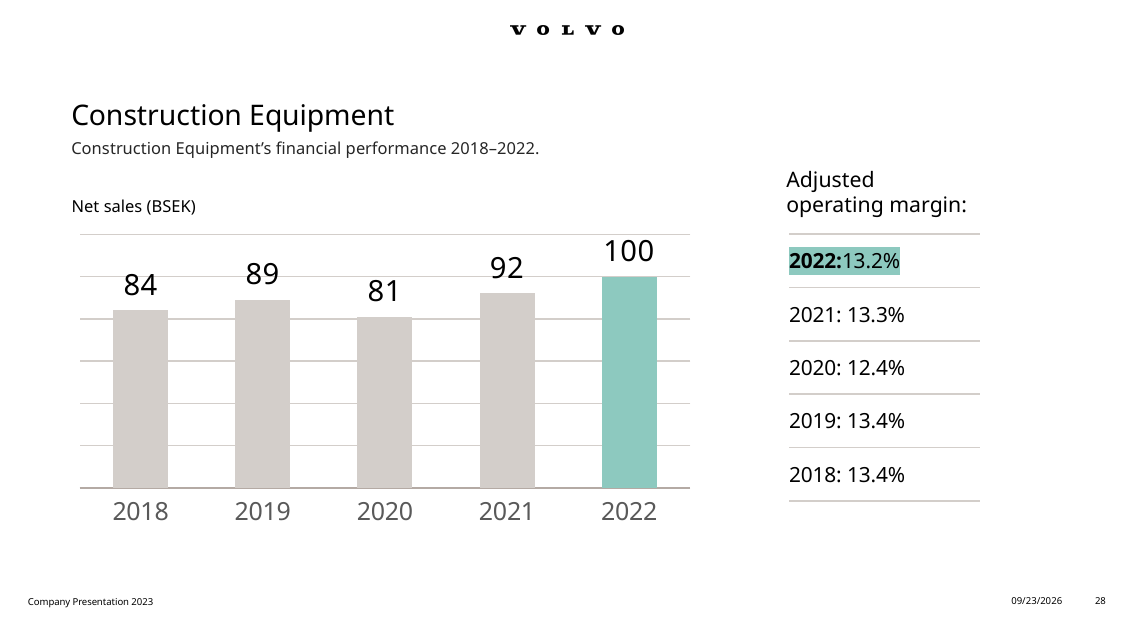
What is the difference in net sales between 2019 and 2018? 5 What is the net sales value for 2018? 84 Which year has higher net sales, 2019 or 2021? 2021 What is the net sales value for 2022? 100 In what unit are net sales shown on the chart? BSEK Do net sales rise or fall from 2020 to 2022? Rise Which year has the highest net sales? 2022 Which year has the lowest net sales? 2020 How many years are shown on the net sales chart? 5 What kind of chart is used to show net sales? Bar chart What is the difference in net sales between 2022 and 2021? 8 What is the net sales value for 2020? 81